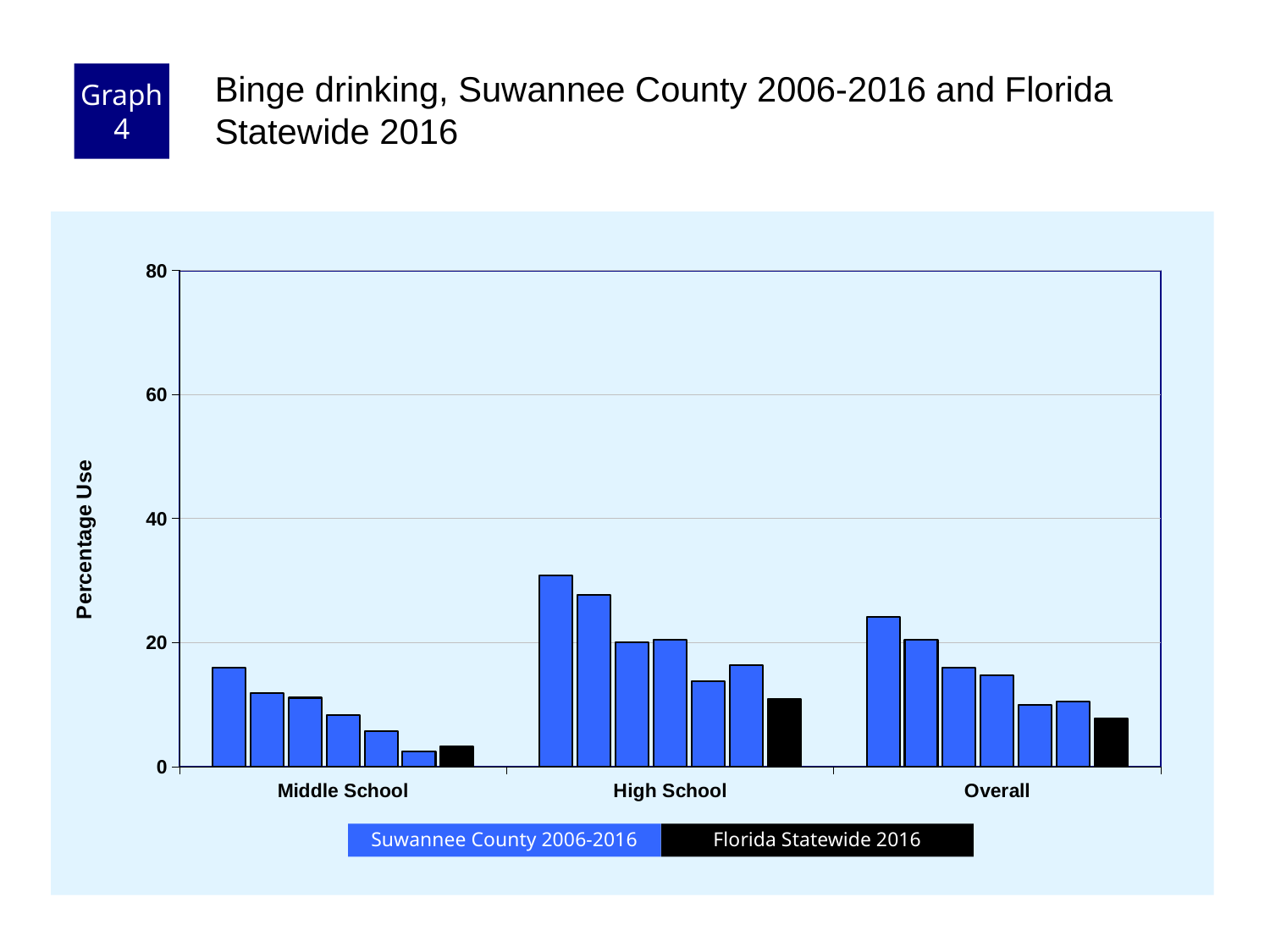
Is the Florida Statewide 2016 value for High School greater or less than 20? less Which colour represents Florida Statewide 2016 in the legend? black Which is larger, the Florida Statewide 2016 bar for High School or the Florida Statewide 2016 bar for Middle School? High School Is the tallest Suwannee County 2006-2016 bar for High School greater or less than 20? greater Is the tallest Suwannee County 2006-2016 bar for Middle School greater or less than 20? less Which category has the tallest bar in the chart? High School How many series does the legend list? 2 What is the label on the y axis? Percentage Use What kind of chart is shown on the slide? bar chart Do the Suwannee County 2006-2016 bars for Middle School rise or fall from left to right? fall Which category has the lowest bars overall? Middle School How many categories are shown along the x axis? 3